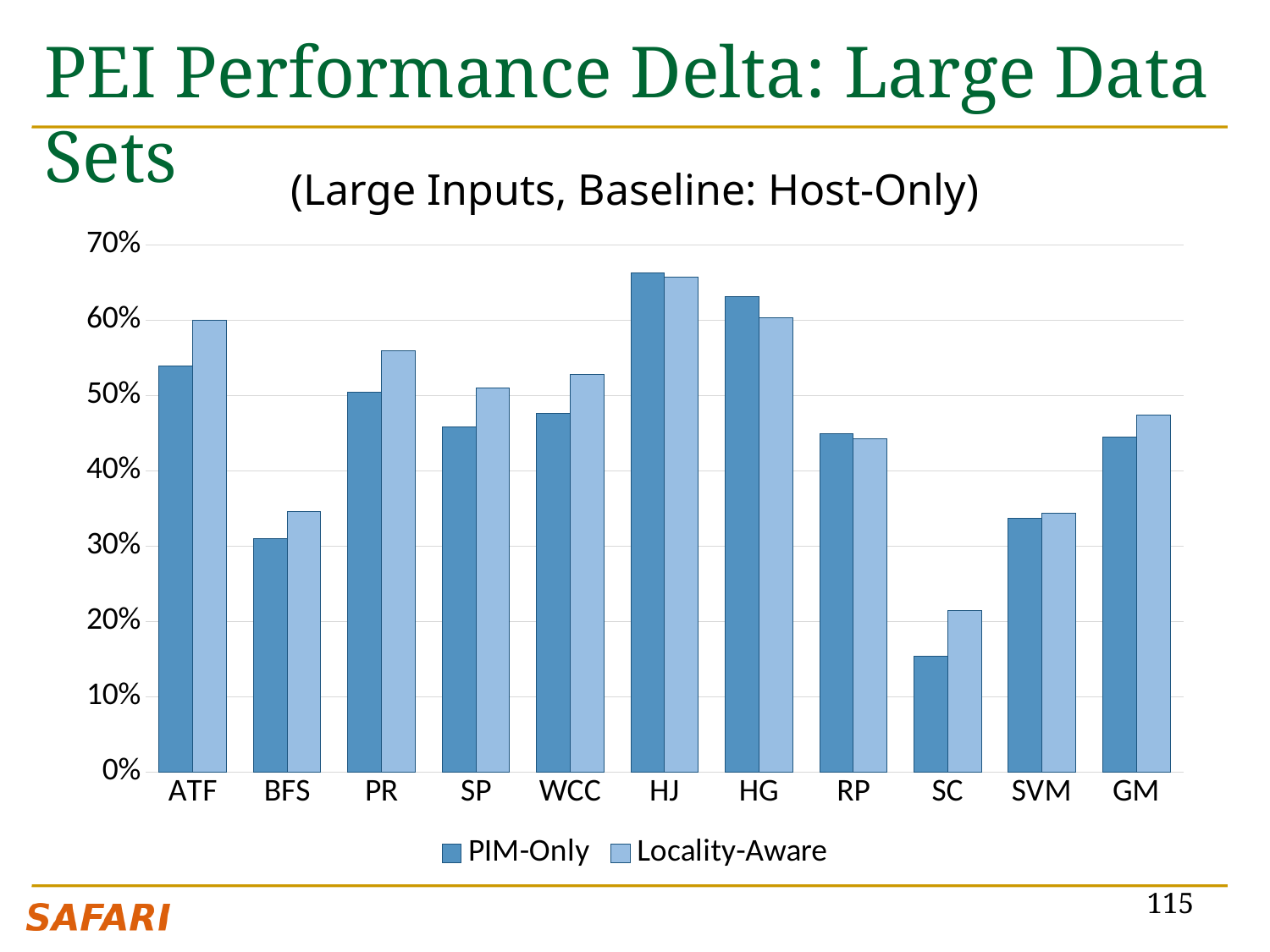
How many categories are shown on the x axis? 11 What kind of chart is shown on the slide? bar chart Which category has the lowest Locality-Aware value? SC For ATF, which is larger: the PIM-Only value or the Locality-Aware value? Locality-Aware What are the two legend entries of the chart? PIM-Only and Locality-Aware Which category has the highest PIM-Only value? HJ Which category has the lowest PIM-Only value? SC Is the PIM-Only value for SC greater or less than 20%? less Is the Locality-Aware value for BFS greater or less than 40%? less How many series does the legend list? 2 Is the PIM-Only value for HG greater or less than 60%? greater